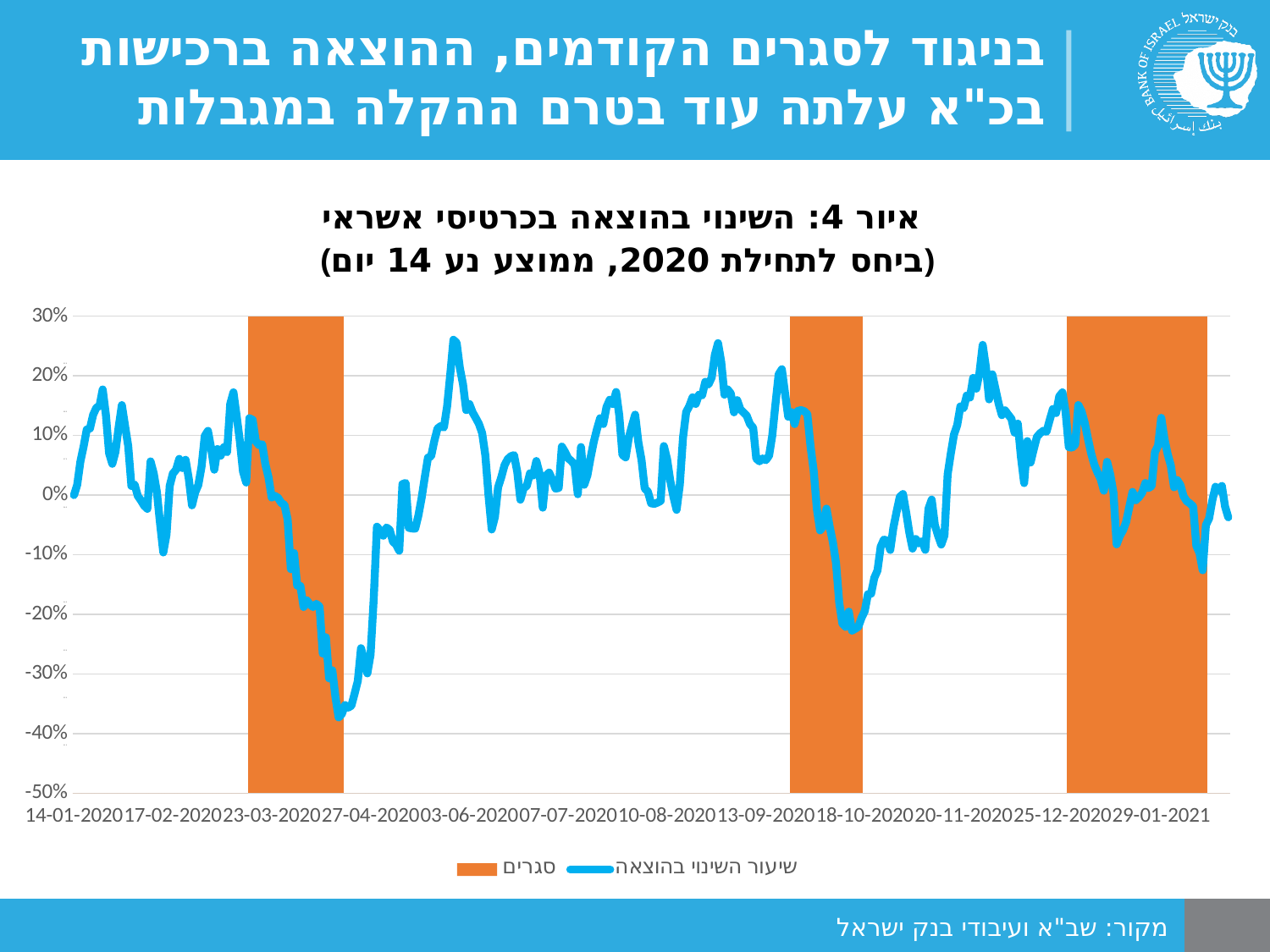
How many shaded lockdown (סגרים) periods are marked on the chart? 3 During which shaded lockdown period does the line reach its lowest value? the first lockdown (March–April 2020) Is the lowest point of the line greater or less than -30%? less How many entries does the chart's legend list? 2 Is the value of the line at 18-10-2020 greater or less than -10%? less Is the value of the line at 13-09-2020 greater or less than 10%? less Which is larger, the value of the line at 27-04-2020 or at 03-06-2020? 03-06-2020 Does the line rise or fall between 17-02-2020 and 27-04-2020? fall What kind of chart is shown on the slide? combination bar and line chart (a line with shaded bar regions) What is the highest value shown on the chart's vertical axis? 30%